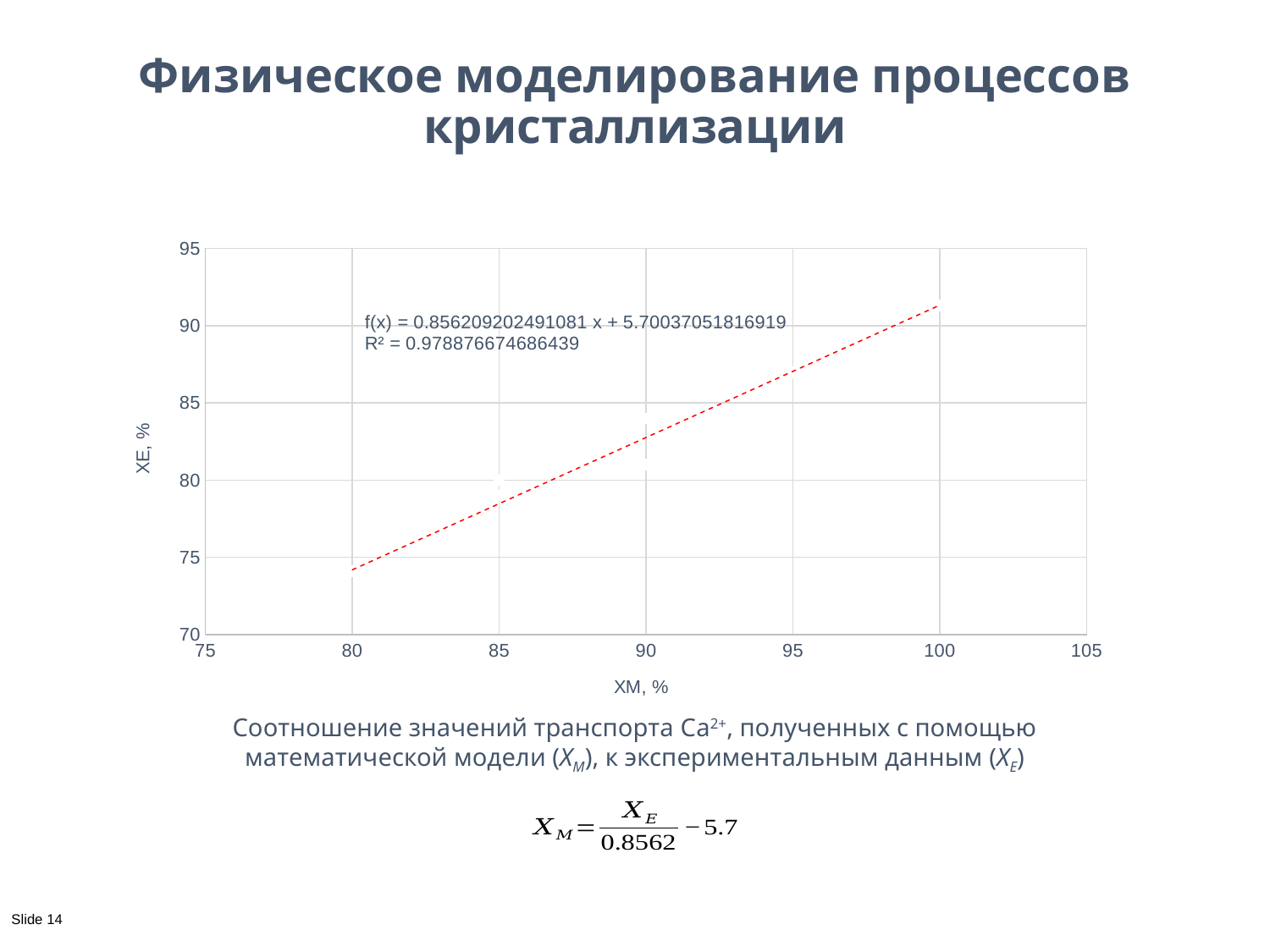
Is the trendline value of XE at XM = 80 greater or less than 75? less Is the trendline value of XE at XM = 90 greater or less than 80? greater Is the trendline value of XE at XM = 100 greater or less than 90? greater What is the maximum value shown on the x axis? 105 What is the label of the x axis? XM, % What is the R² value printed on the chart? 0.978876674686439 What kind of chart is shown on the slide? Scatter chart with a trendline What is the minimum value shown on the y axis? 70 What is the label of the y axis? XE, % What is the trendline equation printed on the chart? f(x) = 0.856209202491081 x + 5.70037051816919 Does the trendline rise or fall as XM increases along the x axis? Rises